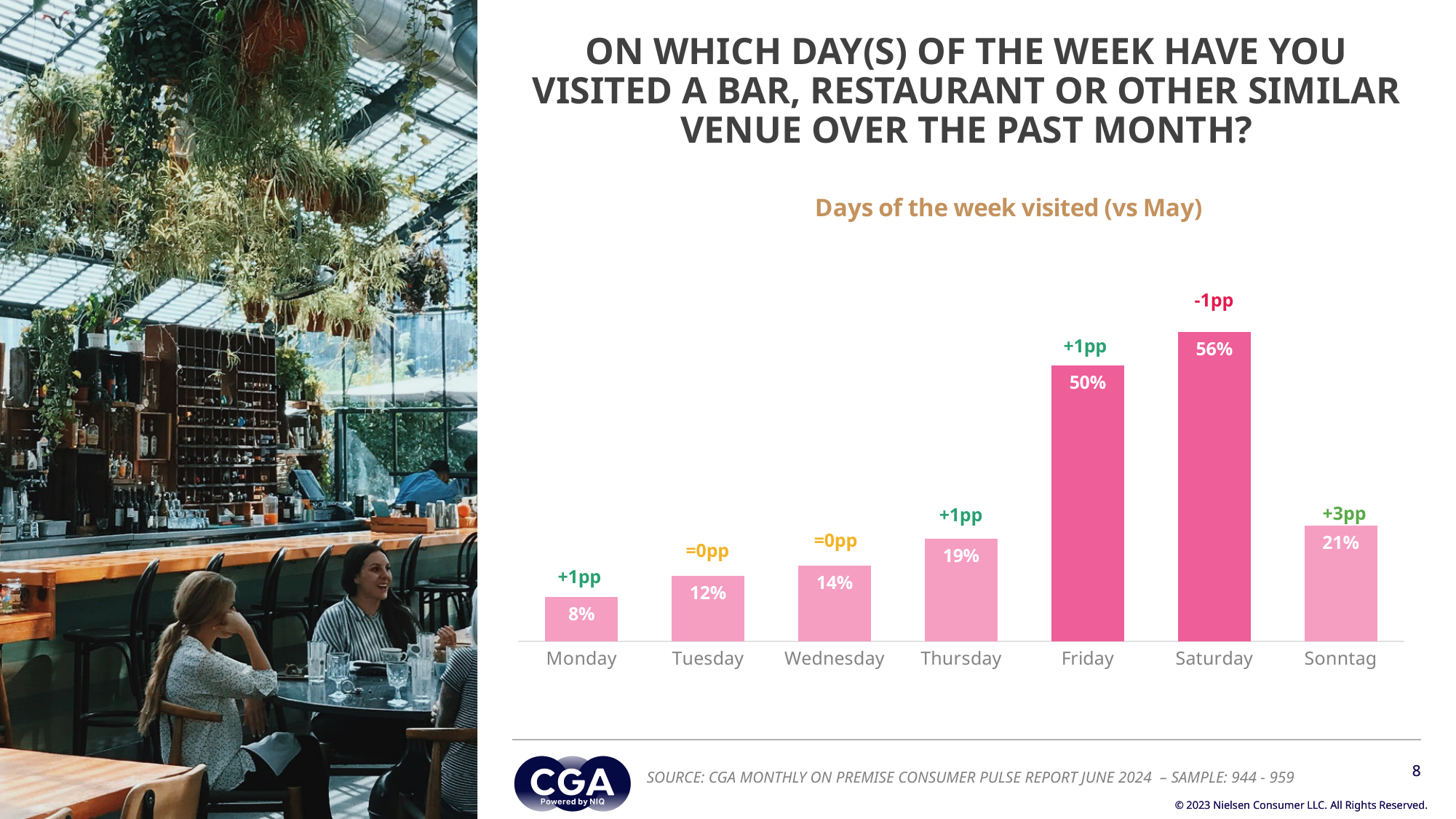
Which is larger, the value for Wednesday or the value for Sonntag? Sonntag What is the change versus May shown above the Sonntag bar? +3pp What is the value shown for Monday? 8% What percentage of respondents visited a venue on Saturday? 56% What is the value shown for Sonntag? 21% What is the difference between the values for Saturday and Friday? 6% Which day of the week has the lowest value? Monday What is the title of the chart? Days of the week visited (vs May) How many days of the week are shown on the chart? 7 What kind of chart is shown on the slide? Bar chart Which day of the week has the highest value? Saturday What is the difference between the values for Thursday and Tuesday? 7%